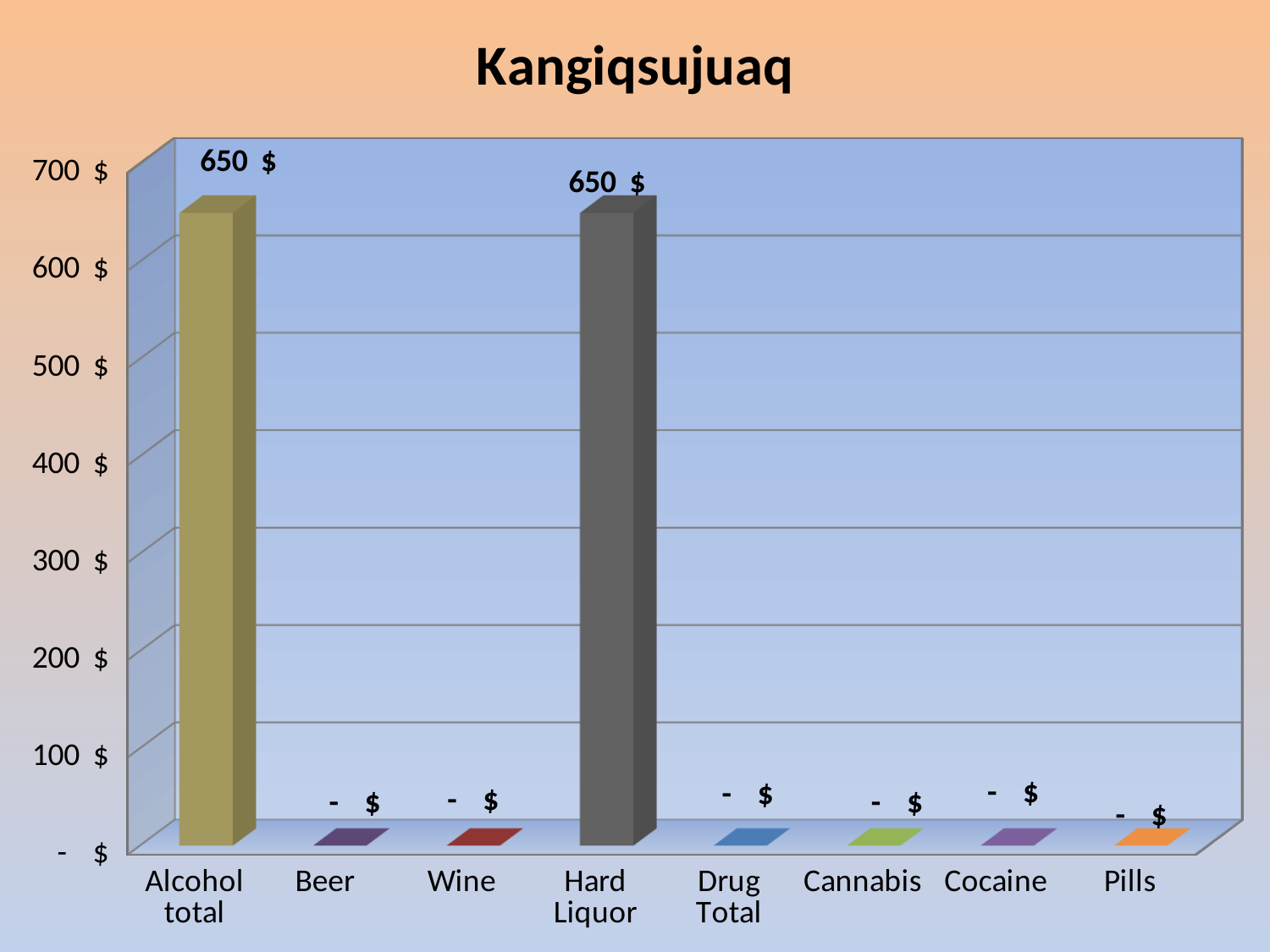
Is the value for Hard Liquor greater or less than 600 $? greater What is the value for Alcohol total? 650 $ What is the title of the chart? Kangiqsujuaq How many categories have a label of "- $"? 6 Which is larger, the value for Hard Liquor or the value for Drug Total? Hard Liquor Which is larger, the value for Alcohol total or the value for Beer? Alcohol total Is the value for Alcohol total greater or less than 700 $? less What value is labelled for Beer? - $ What value is labelled for Cannabis? - $ What is the value for Hard Liquor? 650 $ How many categories are shown on the x axis? 8 What kind of chart is shown on the slide? Bar chart